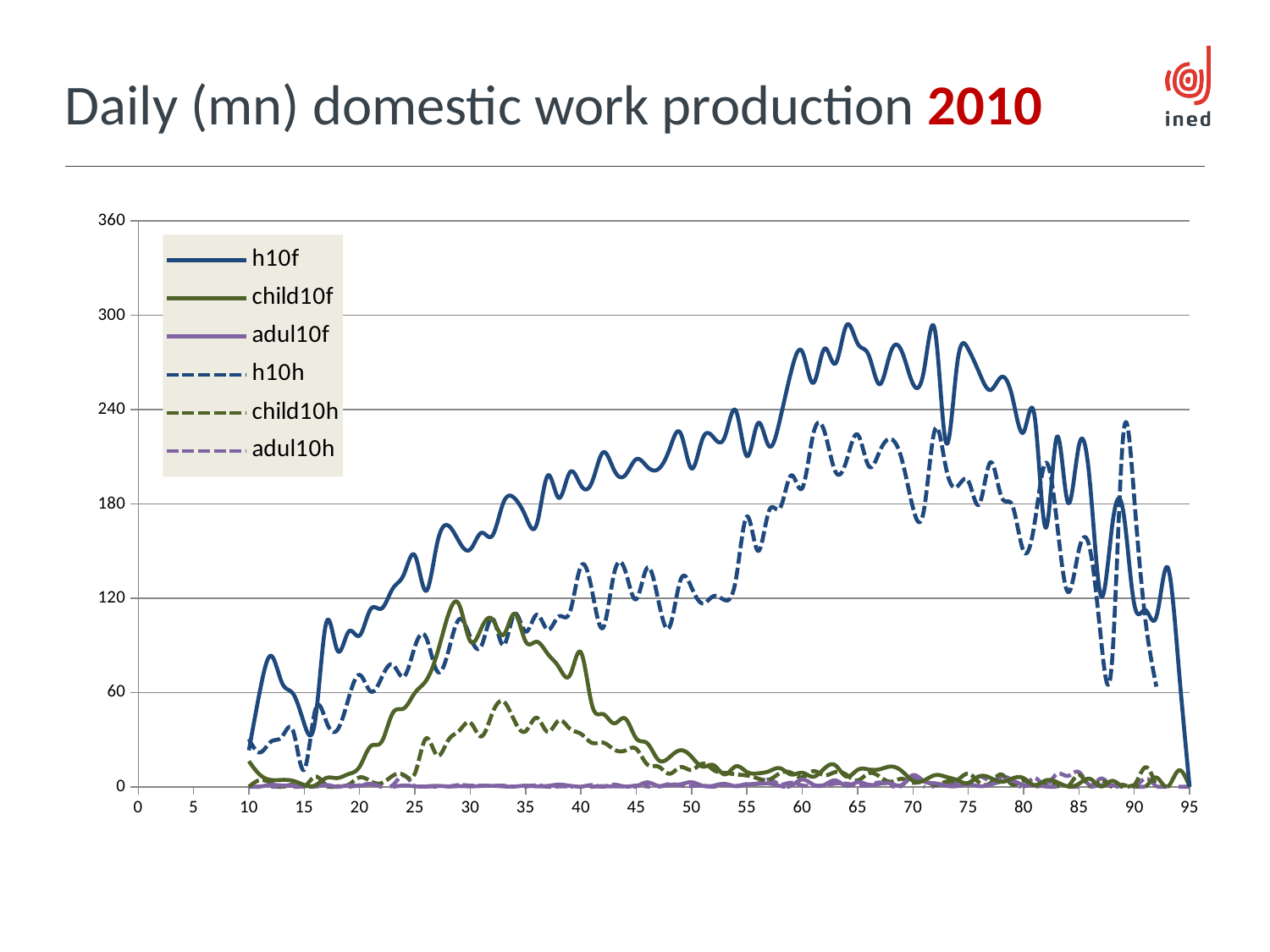
Is the value for h10h at age 40 greater or less than 180? less What kind of chart is shown on the slide? line chart How many series does the legend list? 6 Is the value for h10f at age 65 greater or less than 240? greater Which series reaches the highest values on the chart? h10f Is the value for h10f at age 30 greater or less than 120? greater Which series are drawn with dashed lines? h10h, child10h, adul10h Does the h10f series rise or fall between ages 10 and 65? rise At age 30, which is larger, child10f or child10h? child10f What is the title of the chart? Daily (mn) domestic work production 2010 At age 65, which is larger, h10f or h10h? h10f